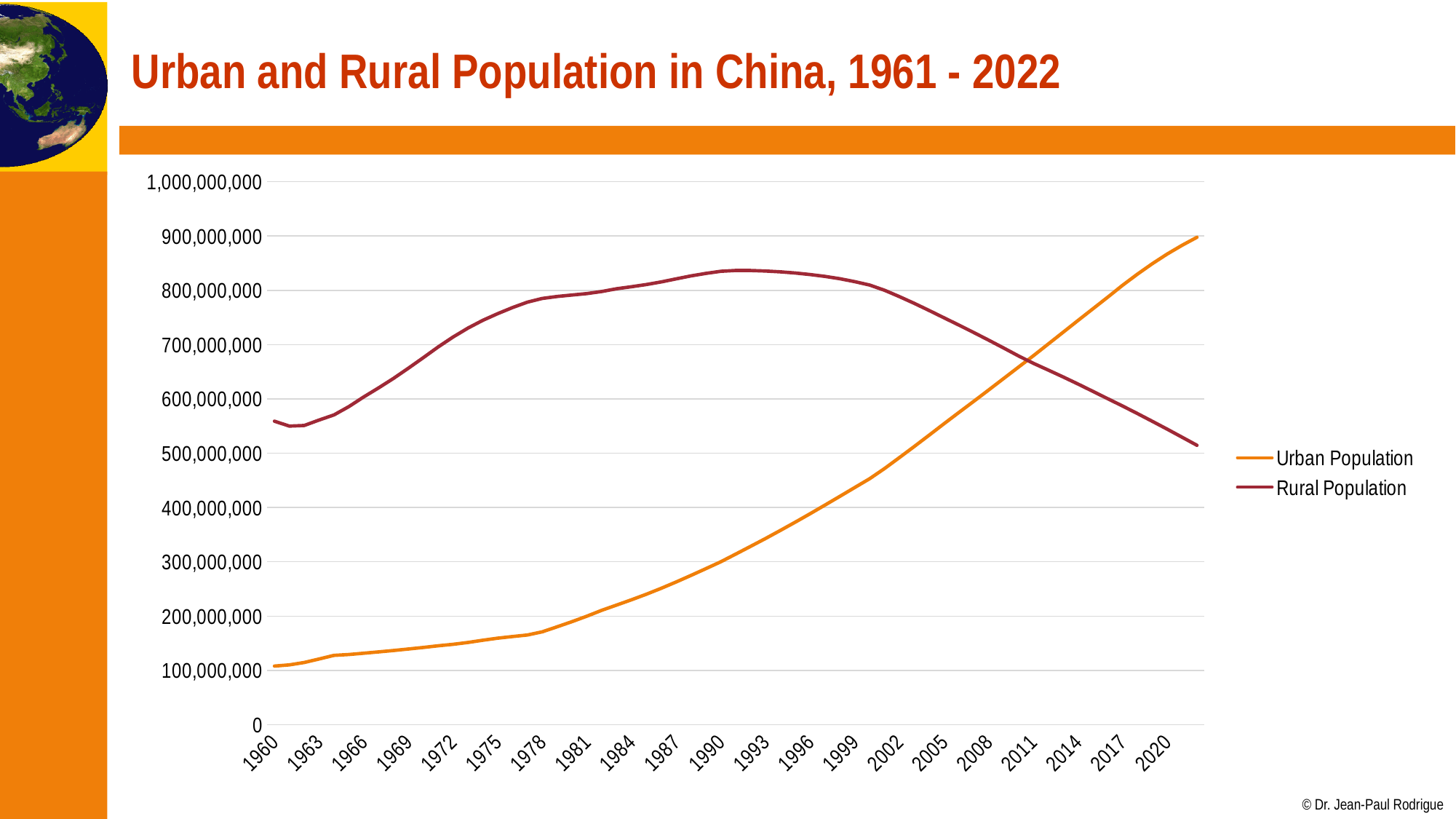
In 1990, which is larger, the Urban Population or the Rural Population? Rural Population Is the Rural Population value in 1960 greater or less than 500,000,000? greater How many series does the legend list? 2 Is the Urban Population value in 1978 greater or less than 200,000,000? less In 2020, which is larger, the Urban Population or the Rural Population? Urban Population Is the Urban Population value in 2020 greater or less than 800,000,000? greater Does the Rural Population line rise or fall between 2002 and 2020? fall What is the title of the slide's chart? Urban and Rural Population in China, 1961 - 2022 Does the Urban Population line rise or fall from 1960 to the end of the series? rise What kind of chart is shown on the slide? line chart Which series reaches the highest value anywhere on the chart? Urban Population What are the two series named in the legend? Urban Population and Rural Population